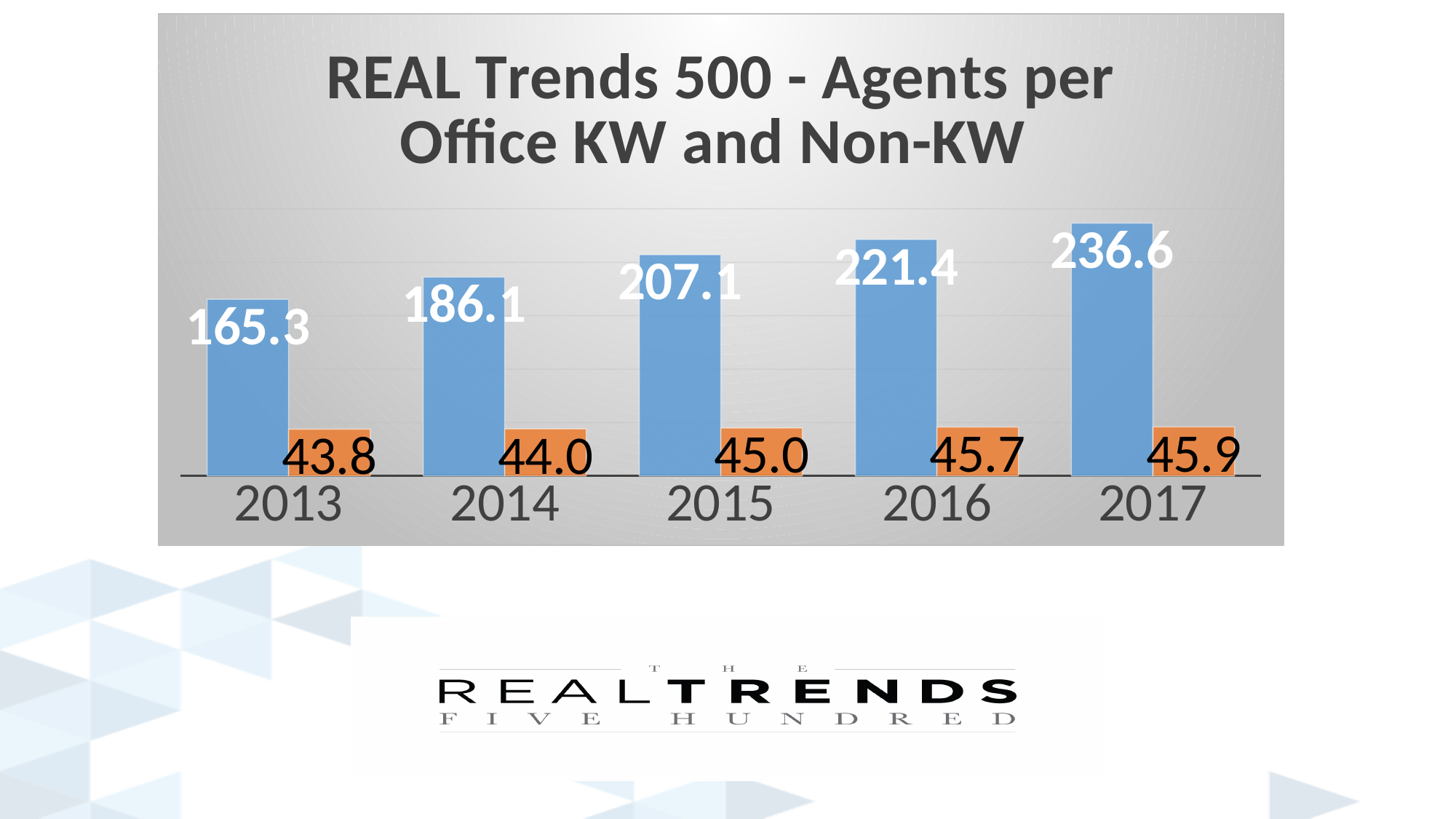
Which is larger in 2016, the blue bar or the orange bar? The blue bar In which year is the blue bar lowest? 2013 Do the blue bar values rise or fall from 2013 to 2017? Rise What is the value of the blue bar for 2017? 236.6 What is the value of the orange bar for 2014? 44.0 What is the value of the blue bar for 2013? 165.3 In which year is the blue bar highest? 2017 What is the difference between the blue and orange bar values in 2015? 162.1 What is the difference between the blue bar values for 2017 and 2013? 71.3 What kind of chart is shown on the slide? Bar chart What is the value of the orange bar for 2016? 45.7 How many years are shown on the x axis? 5